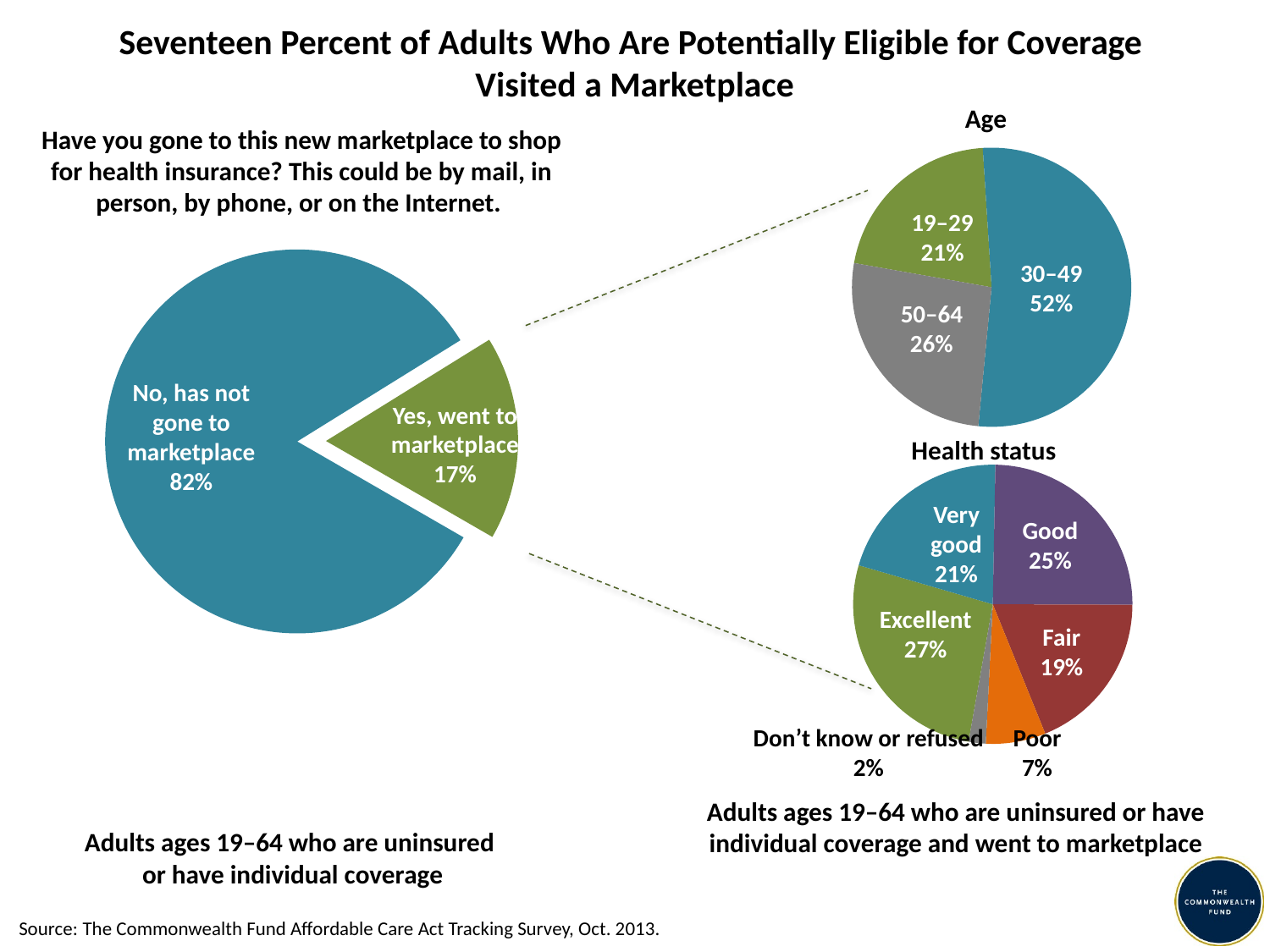
What type of chart is used for the Age breakdown? Pie chart In the Health status pie chart, what share of adults reported excellent health? 27% In the Health status pie chart, which category has the smallest share? Don't know or refused How many categories are shown in the Health status pie chart? 6 In the Age pie chart, what share of adults who went to the marketplace are ages 30–49? 52% In the large pie chart on the left, what share of adults said they had not gone to the marketplace? 82% In the Age pie chart, which age group has the smallest share? 19–29 In the large pie chart on the left, what share of adults said they had gone to the marketplace? 17% In the Health status pie chart, which category has the largest share? Excellent In the Age pie chart, what is the difference between the 50–64 share and the 19–29 share? 5 percentage points In the Health status pie chart, which is larger: the share for Good or the share for Fair? Good How many age groups are shown in the Age pie chart? 3